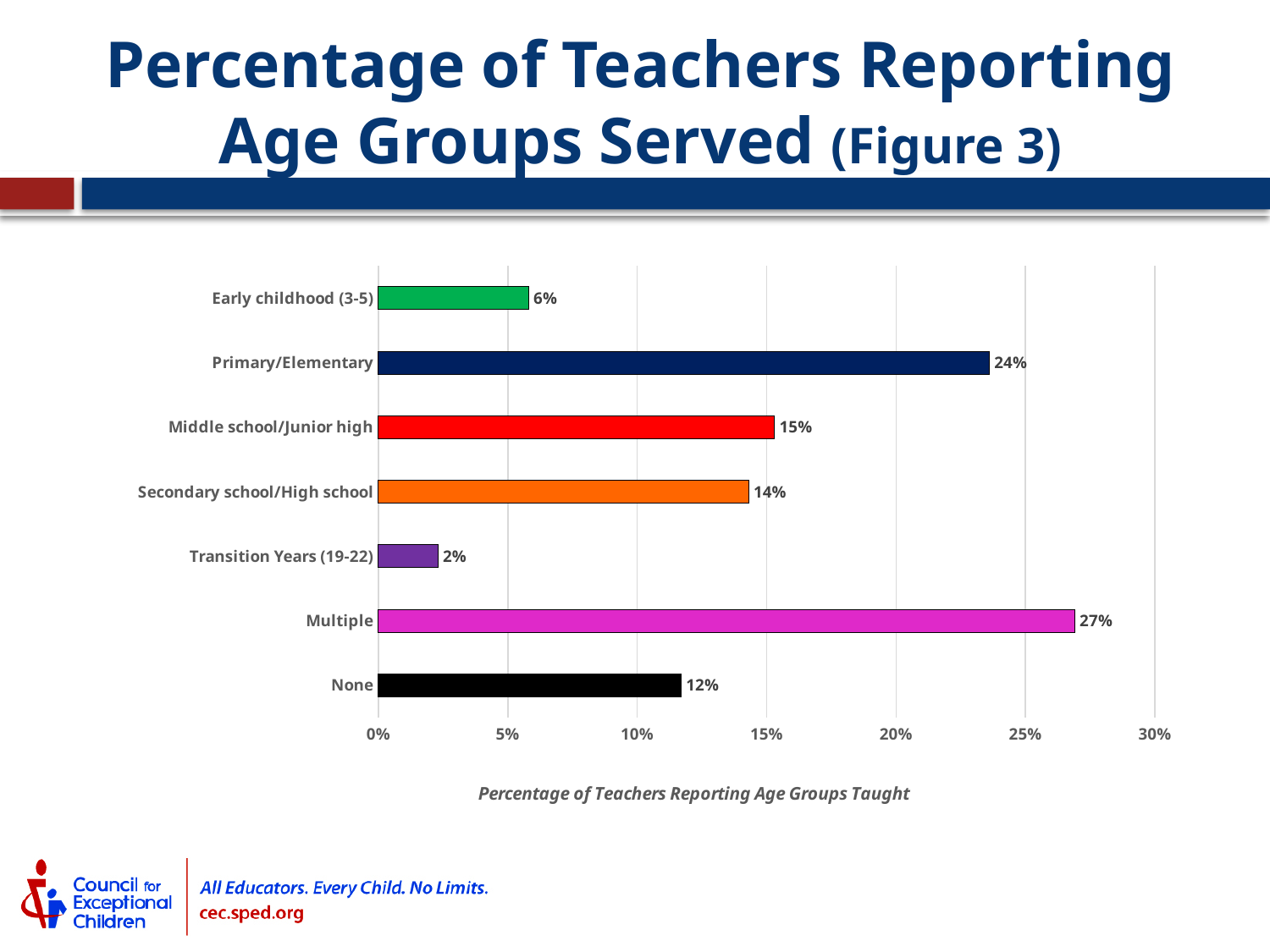
How many age group categories are shown in the chart? 7 Which is larger, the value for Middle school/Junior high or Secondary school/High school? Middle school/Junior high Is the value for Primary/Elementary greater or less than 20%? greater What is the difference in percentage points between Multiple and None? 15 What colour is the bar for None? Black What kind of chart is shown on the slide? Bar chart What percentage of teachers reported serving Early childhood (3-5)? 6% What is the axis label shown below the chart? Percentage of Teachers Reporting Age Groups Taught Which age group category has the highest percentage of teachers? Multiple What percentage of teachers reported serving Transition Years (19-22)? 2% What percentage of teachers reported serving Primary/Elementary? 24% Which age group category has the lowest percentage of teachers? Transition Years (19-22)